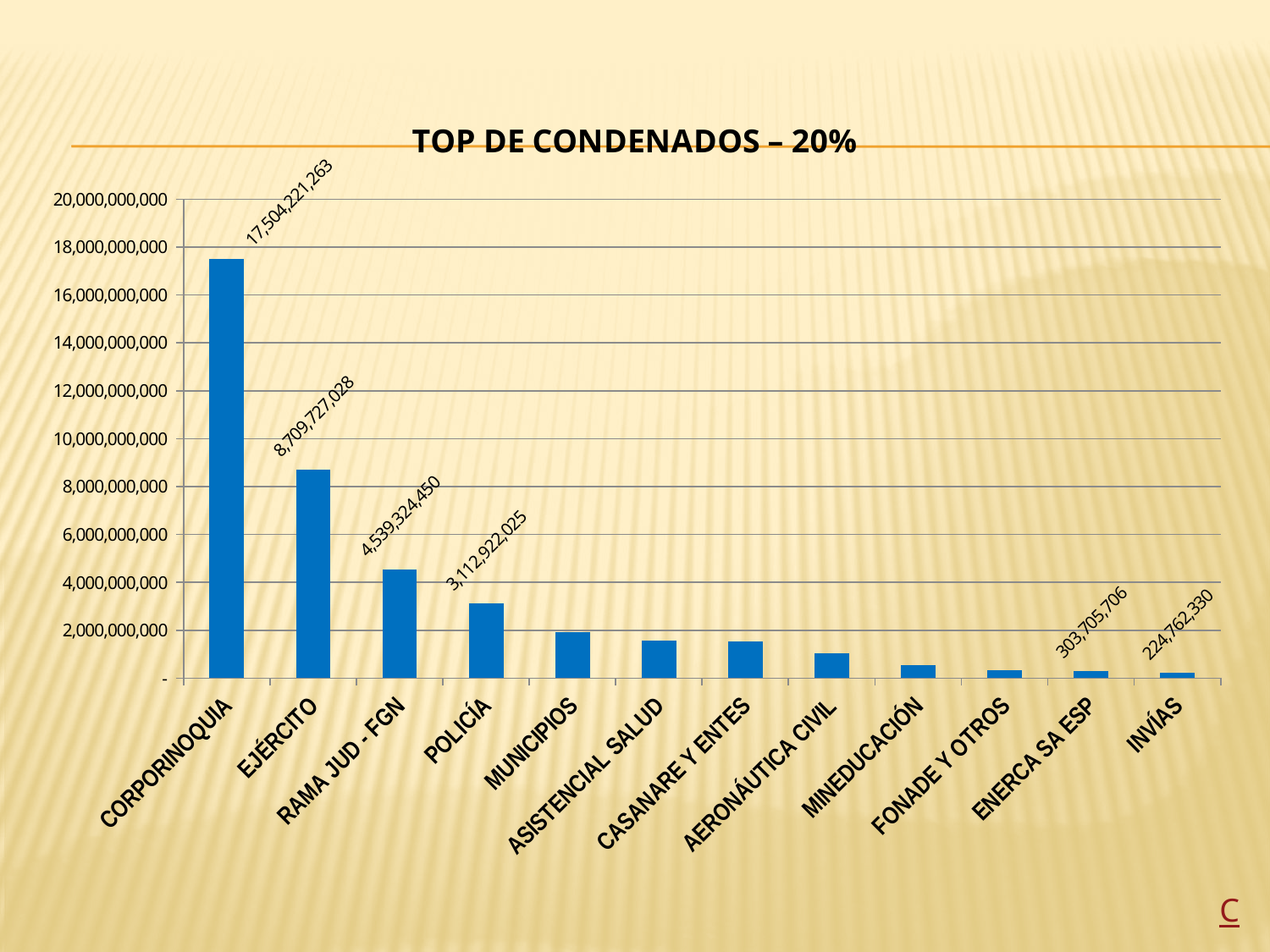
Which category has the lowest value? INVÍAS What is the value for EJÉRCITO? 8,709,727,028 Which is larger, the value for EJÉRCITO or the value for POLICÍA? EJÉRCITO How many categories are shown on the x axis? 12 Which category has the highest value? CORPORINOQUIA Is the value for AERONÁUTICA CIVIL greater or less than 2,000,000,000? less What is the value for CORPORINOQUIA? 17,504,221,263 What is the value for RAMA JUD - FGN? 4,539,324,450 What type of chart is shown on the slide? bar chart What is the title of the chart? TOP DE CONDENADOS – 20% What is the value for INVÍAS? 224,762,330 What is the difference between the values for CORPORINOQUIA and EJÉRCITO? 8,794,494,235